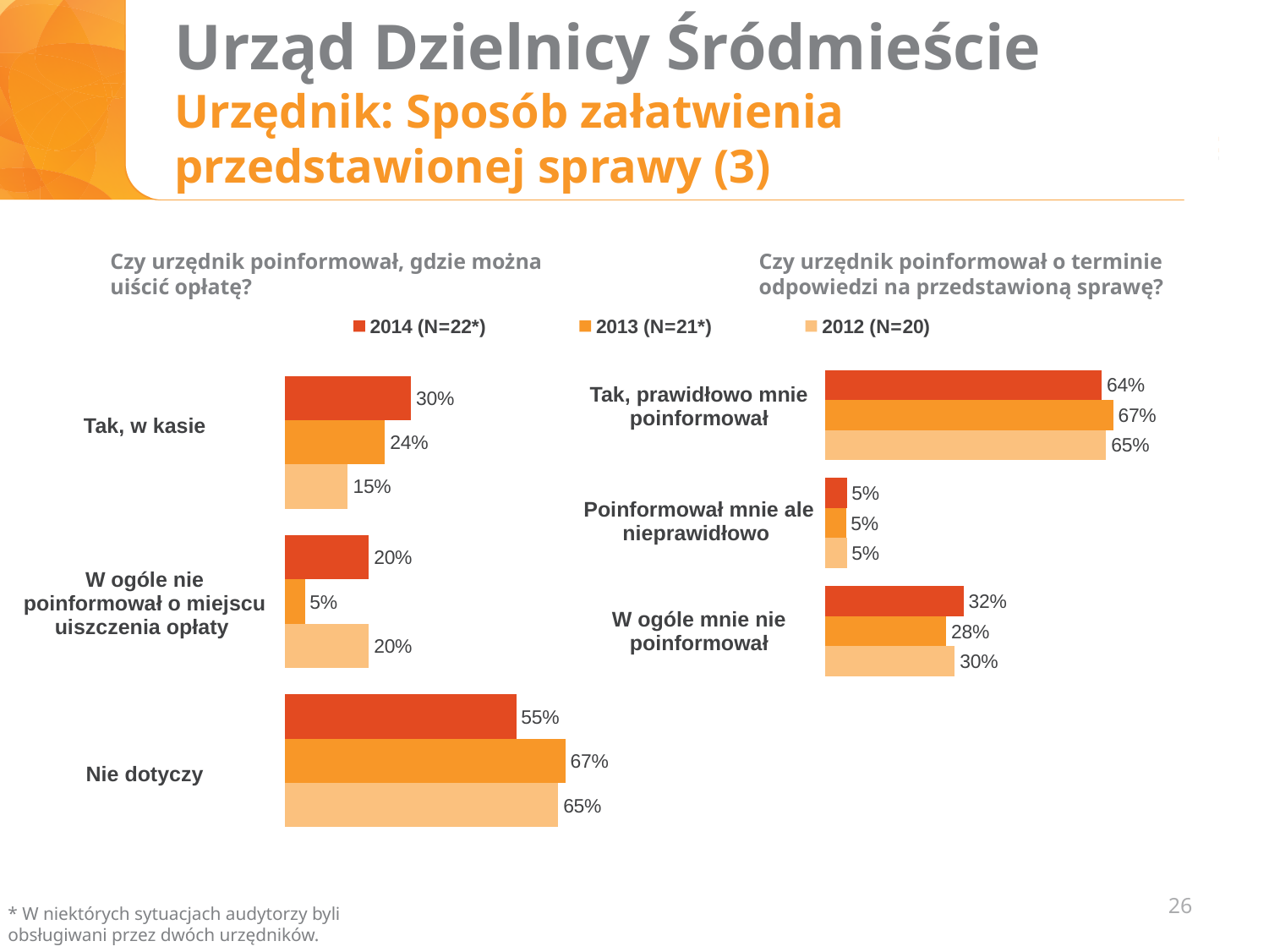
What sample size (N) does the legend give for the 2012 series? N=20 In the right chart (Czy urzędnik poinformował o terminie odpowiedzi na przedstawioną sprawę?), which is larger for 'W ogóle mnie nie poinformował': the 2014 value or the 2013 value? 2014 In the left chart (Czy urzędnik poinformował, gdzie można uiścić opłatę?), what is the value for 'Tak, w kasie' in 2014? 30% How many series does the legend list? 3 In the right chart (Czy urzędnik poinformował o terminie odpowiedzi na przedstawioną sprawę?), what is the value for 'W ogóle mnie nie poinformował' in 2012? 30% In the left chart (Czy urzędnik poinformował, gdzie można uiścić opłatę?), what is the value for 'Nie dotyczy' in 2013? 67% In the left chart (Czy urzędnik poinformował, gdzie można uiścić opłatę?), what is the difference between the 2014 and 2012 values for 'Tak, w kasie'? 15 percentage points In the right chart (Czy urzędnik poinformował o terminie odpowiedzi na przedstawioną sprawę?), which category has the highest value in 2014? Tak, prawidłowo mnie poinformował What kind of chart is the right chart (Czy urzędnik poinformował o terminie odpowiedzi na przedstawioną sprawę?)? Bar chart How many categories does the left chart (Czy urzędnik poinformował, gdzie można uiścić opłatę?) show? 3 In the right chart (Czy urzędnik poinformował o terminie odpowiedzi na przedstawioną sprawę?), what is the value for 'Poinformował mnie ale nieprawidłowo' in 2013? 5% In the left chart (Czy urzędnik poinformował, gdzie można uiścić opłatę?), which category has the lowest value in 2013? W ogóle nie poinformował o miejscu uiszczenia opłaty